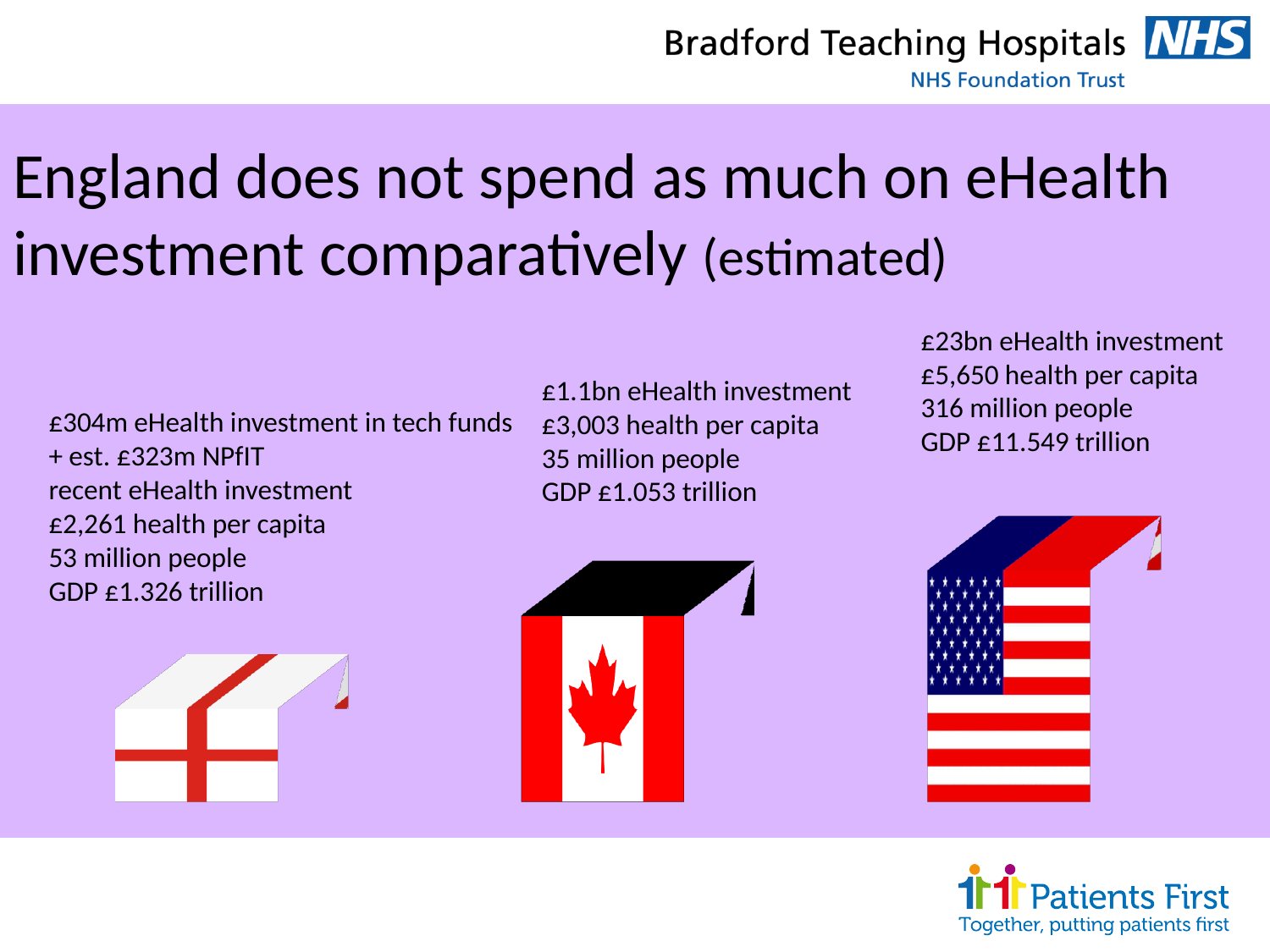
What eHealth investment figure is printed above the middle flag block? £1.1bn Which flag block is drawn shortest on the slide? the left-hand block What is the title of the slide? England does not spend as much on eHealth investment comparatively (estimated) What population figure is printed for the right-hand flag block? 316 million people What is the difference between the health per capita printed for the right-hand block and the middle block? £2,647 Which has the higher printed health per capita, the middle block or the right-hand block? the right-hand block What eHealth investment figure is printed above the right-hand (tallest) flag block? £23bn How many flag blocks are compared on the slide? 3 What GDP figure is printed for the left-hand flag block? £1.326 trillion What health per capita figure is printed for the left-hand flag block? £2,261 What health per capita figure is printed for the middle flag block? £3,003 Which flag block is drawn tallest on the slide? the right-hand block